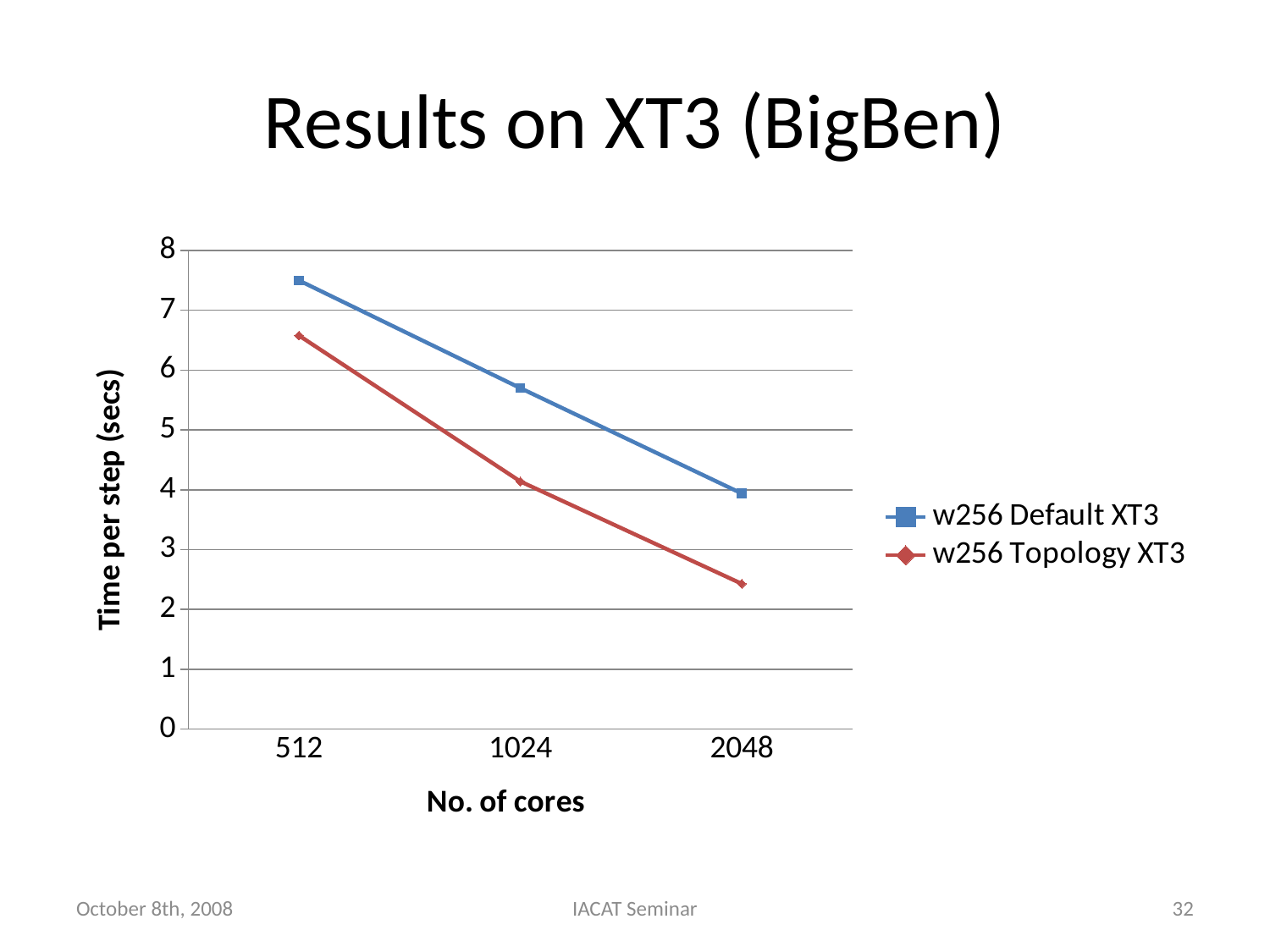
Is the value for w256 Topology XT3 at 512 cores greater or less than 6? greater How many core counts are plotted along the x axis? 3 Is the value for w256 Topology XT3 at 2048 cores greater or less than 3? less Is the value for w256 Default XT3 at 512 cores greater or less than 7? greater What is the label of the y axis? Time per step (secs) At 2048 cores, which series has the larger time per step, w256 Default XT3 or w256 Topology XT3? w256 Default XT3 At which number of cores is the time per step for w256 Default XT3 highest? 512 Does the time per step for w256 Default XT3 rise or fall as the number of cores increases? fall At which number of cores is the time per step for w256 Topology XT3 lowest? 2048 What kind of chart is shown on the slide? line chart How many series does the legend list? 2